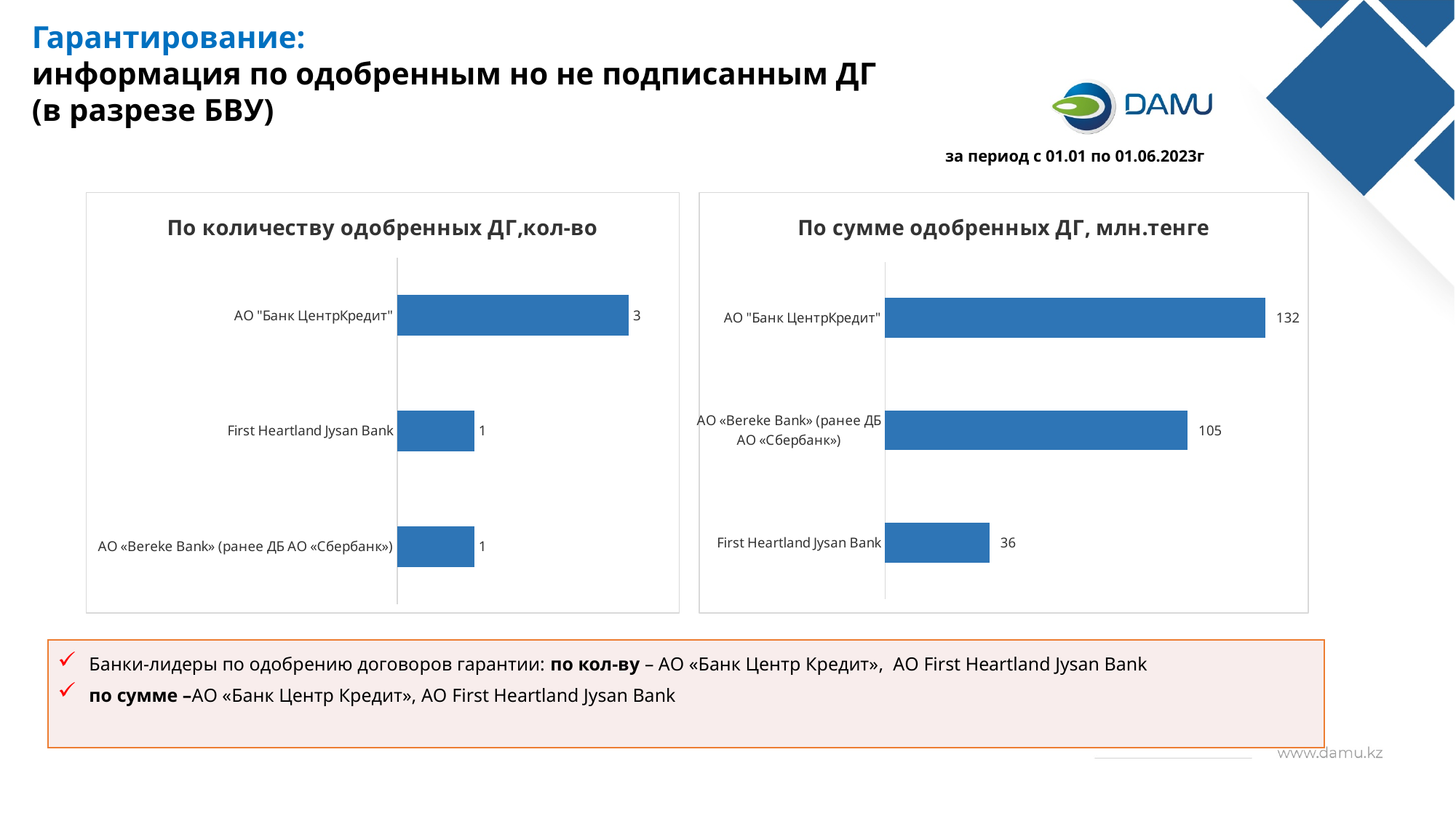
In the chart "По сумме одобренных ДГ, млн.тенге", what is the value for First Heartland Jysan Bank? 36 What type of chart is "По сумме одобренных ДГ, млн.тенге"? Bar chart In the chart "По количеству одобренных ДГ,кол-во", what is the value for АО "Банк ЦентрКредит"? 3 In the chart "По сумме одобренных ДГ, млн.тенге", what is the total of all three bars? 273 What is the title of the left chart on the slide? По количеству одобренных ДГ,кол-во In the chart "По количеству одобренных ДГ,кол-во", what is the value for First Heartland Jysan Bank? 1 In the chart "По количеству одобренных ДГ,кол-во", how many banks are shown? 3 In the chart "По сумме одобренных ДГ, млн.тенге", what is the difference between АО "Банк ЦентрКредит" and АО «Bereke Bank» (ранее ДБ АО «Сбербанк»)? 27 In the chart "По сумме одобренных ДГ, млн.тенге", which is larger: the value for АО «Bereke Bank» (ранее ДБ АО «Сбербанк») or for First Heartland Jysan Bank? АО «Bereke Bank» (ранее ДБ АО «Сбербанк») In the chart "По количеству одобренных ДГ,кол-во", which bank has the highest value? АО "Банк ЦентрКредит" In the chart "По сумме одобренных ДГ, млн.тенге", which bank has the lowest value? First Heartland Jysan Bank In the chart "По сумме одобренных ДГ, млн.тенге", what is the value for АО «Bereke Bank» (ранее ДБ АО «Сбербанк»)? 105